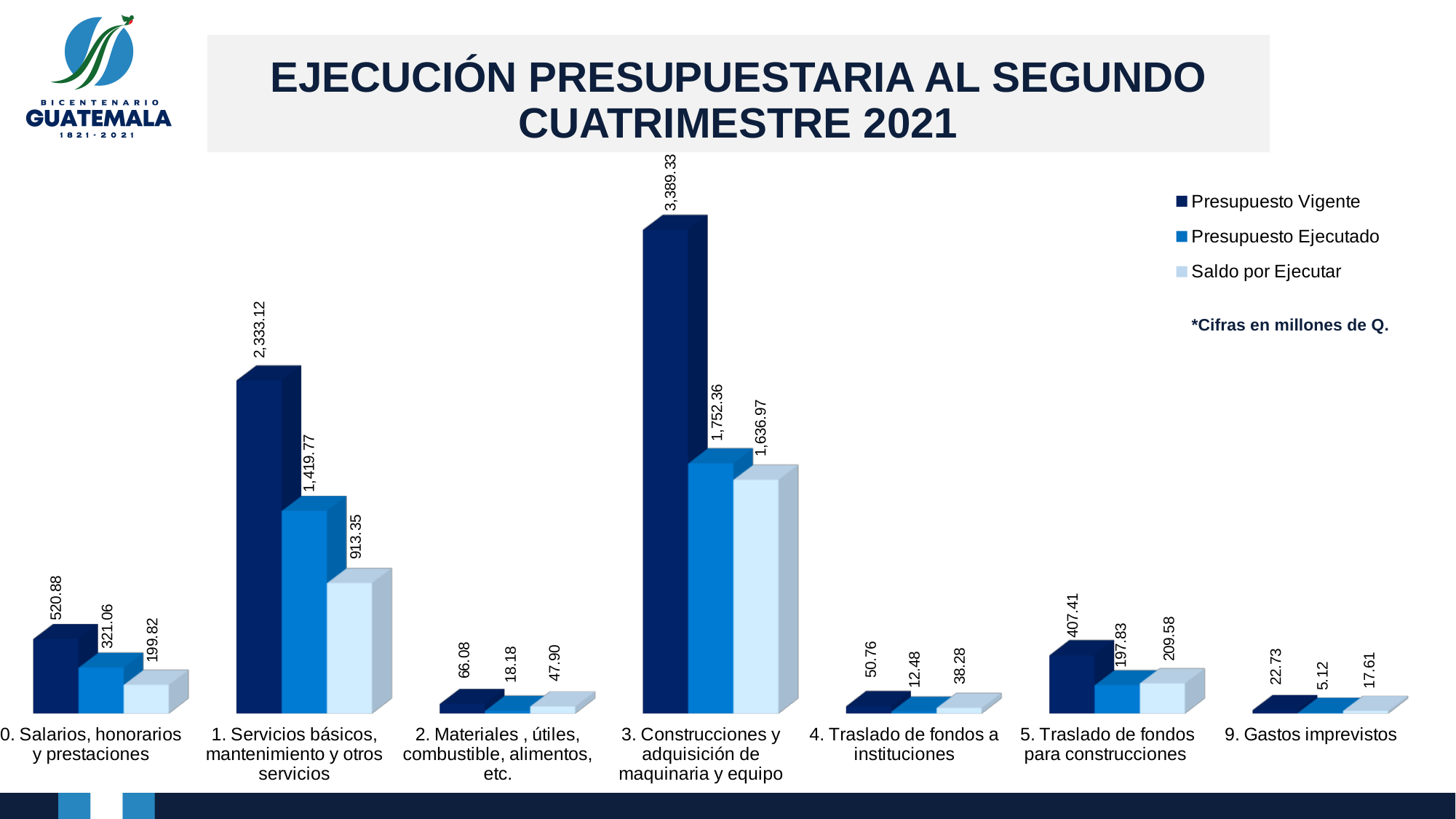
Which category has the highest Presupuesto Vigente? 3. Construcciones y adquisición de maquinaria y equipo How many categories are shown on the x axis of the chart? 7 What kind of chart is shown on the slide? Bar chart What is the Presupuesto Ejecutado value for '1. Servicios básicos, mantenimiento y otros servicios'? 1,419.77 What is the difference between Presupuesto Vigente and Presupuesto Ejecutado for '5. Traslado de fondos para construcciones'? 209.58 Which category has the lowest Presupuesto Ejecutado? 9. Gastos imprevistos What is the Presupuesto Ejecutado value for '9. Gastos imprevistos'? 5.12 What is the Presupuesto Vigente value for '3. Construcciones y adquisición de maquinaria y equipo'? 3,389.33 Which is larger for '2. Materiales, útiles, combustible, alimentos, etc.': Presupuesto Ejecutado or Saldo por Ejecutar? Saldo por Ejecutar What is the Saldo por Ejecutar value for '0. Salarios, honorarios y prestaciones'? 199.82 In what units are the figures in the chart expressed, according to the note on the slide? Millones de Q. How many series does the legend list? 3